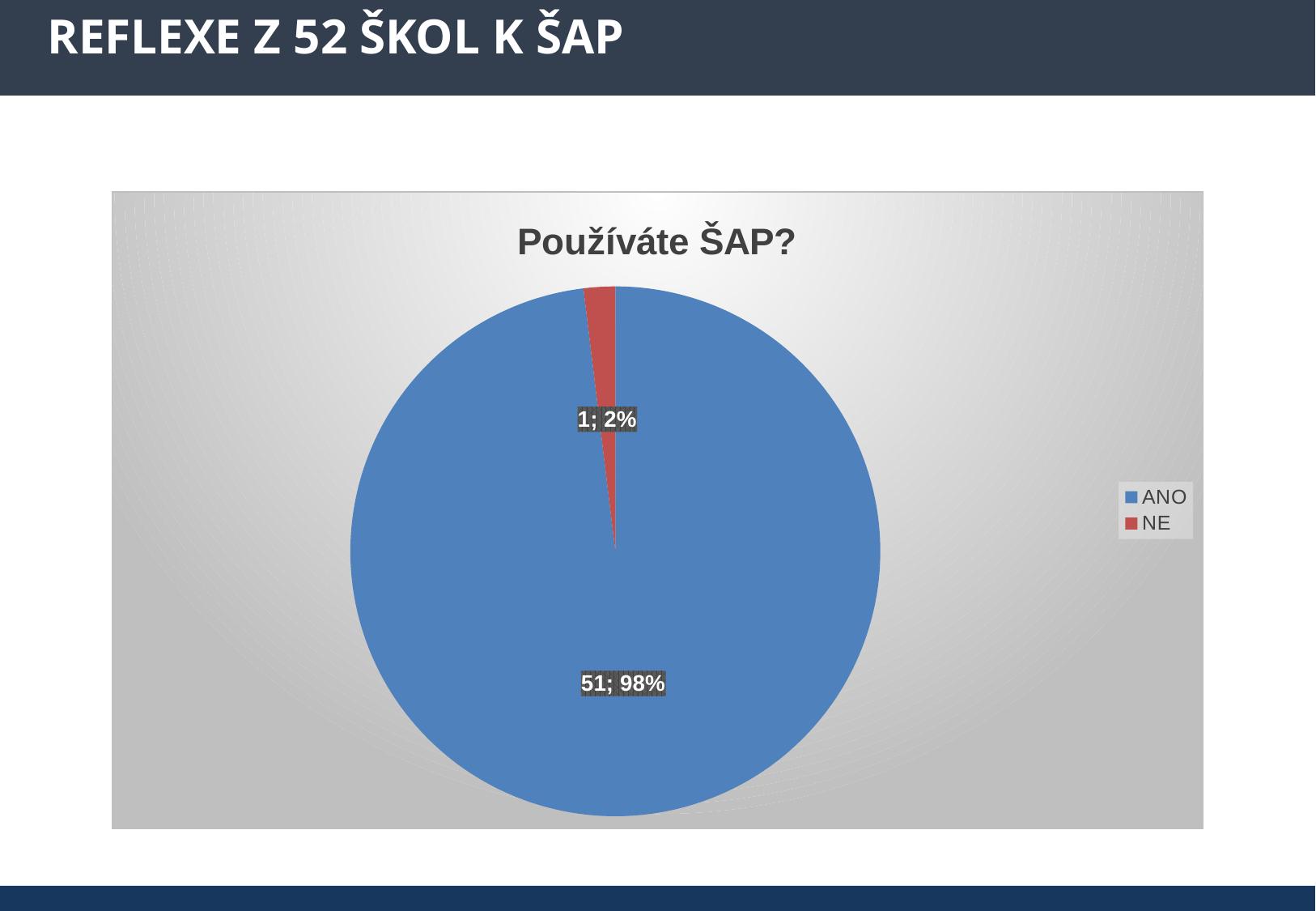
What kind of chart is shown on the slide? pie chart What is the count for NE? 1 How many slices does the pie chart have? 2 What share of the pie does ANO represent? 98% What is the title of the chart? Používáte ŠAP? Which category has the smallest slice? NE What share of the pie does NE represent? 2% Which colour represents NE in the chart? red How many entries does the legend list? 2 What is the count for ANO? 51 What is the difference between the counts for ANO and NE? 50 Which category has the largest slice? ANO